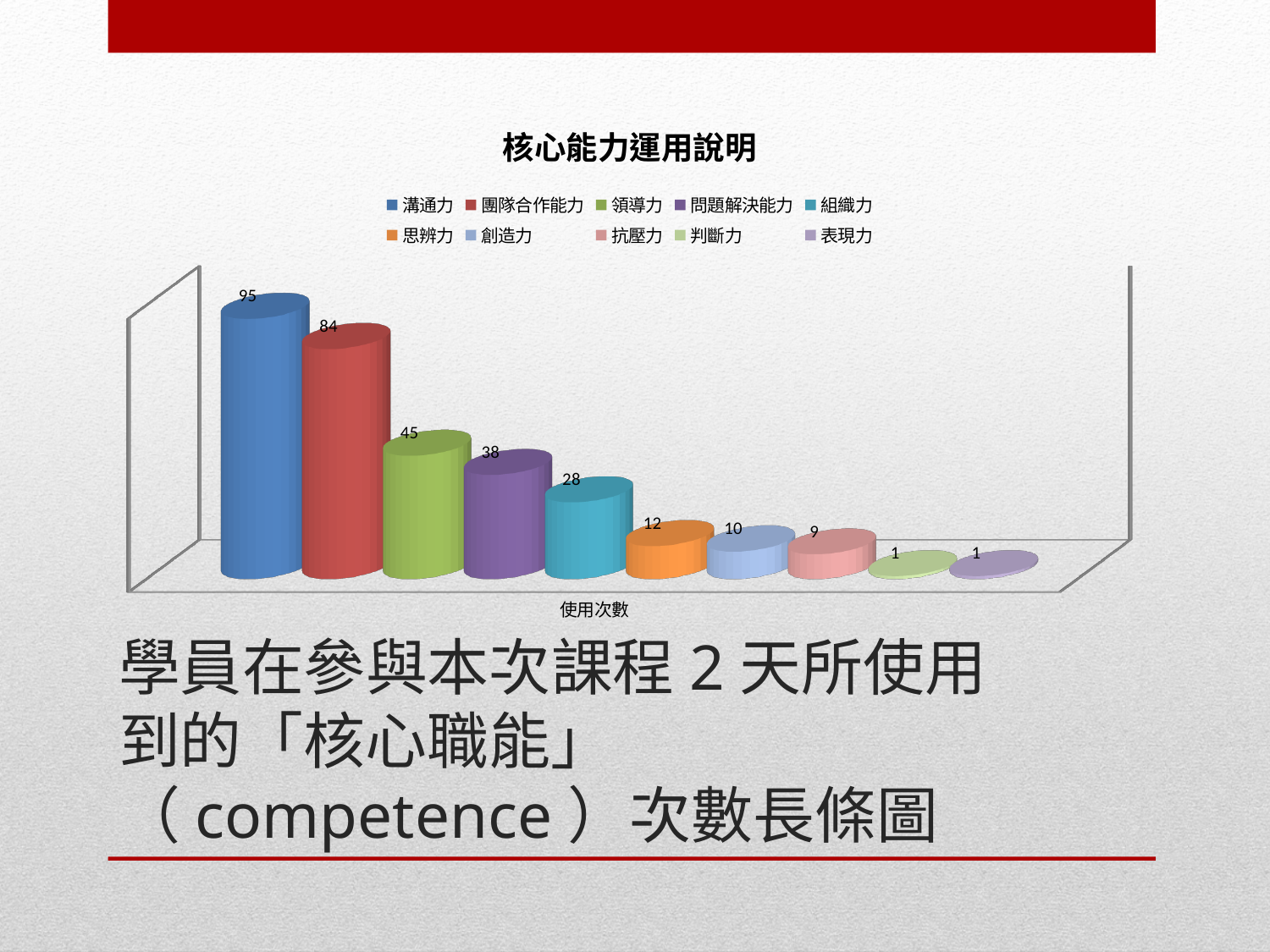
What is the difference between the values for 溝通力 and 團隊合作能力? 11 What is the label shown below the horizontal axis of the chart? 使用次數 What is the title of the chart? 核心能力運用說明 How many series does the legend list? 10 What is the value for 組織力? 28 What kind of chart is shown on the slide? bar chart Which is larger, the value for 思辨力 or the value for 創造力? 思辨力 Which competence has the highest value? 溝通力 What is the value for 抗壓力? 9 What is the difference between the values for 領導力 and 問題解決能力? 7 What is the value for 溝通力? 95 What is the value for 團隊合作能力? 84